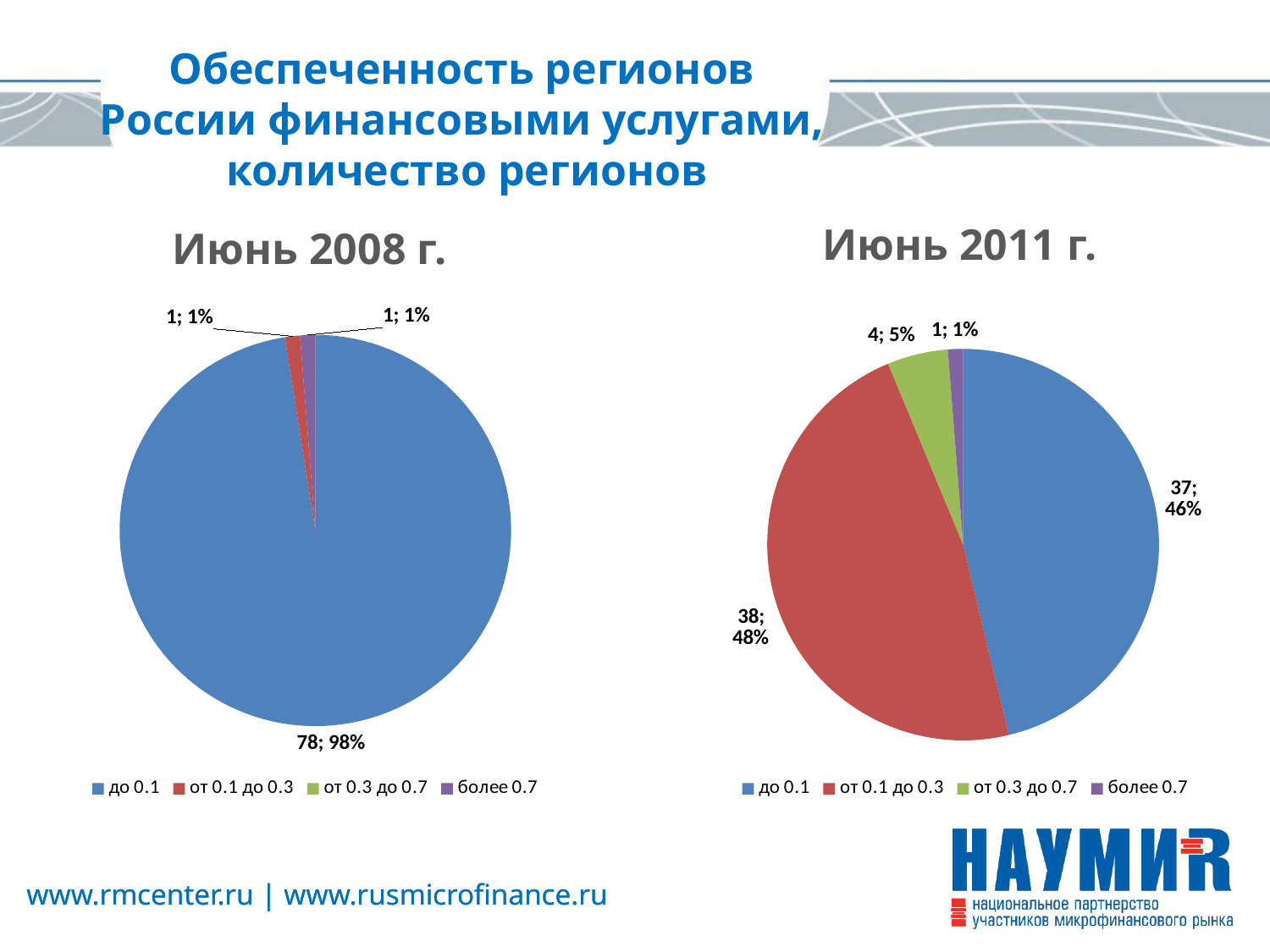
In the 'Июнь 2008 г.' chart, how many regions are in the 'до 0.1' category? 78 In the 'Июнь 2011 г.' chart, which category has the smallest slice? более 0.7 In the 'Июнь 2011 г.' chart, how many regions are in the 'от 0.1 до 0.3' category? 38 In the 'Июнь 2011 г.' chart, what colour is the 'от 0.3 до 0.7' slice? Green In the 'Июнь 2011 г.' chart, how many regions are in the 'от 0.3 до 0.7' category? 4 In the 'Июнь 2011 г.' chart, what is the difference in the number of regions between 'от 0.1 до 0.3' and 'до 0.1'? 1 In the 'Июнь 2011 г.' chart, which category has the largest slice? от 0.1 до 0.3 What type of chart is used for 'Июнь 2011 г.'? Pie chart How many categories does the legend of the 'Июнь 2008 г.' chart list? 4 Which chart has more regions in the 'до 0.1' category, 'Июнь 2008 г.' or 'Июнь 2011 г.'? Июнь 2008 г. In the 'Июнь 2008 г.' chart, what share of the pie does the 'до 0.1' slice take? 98% In the 'Июнь 2011 г.' chart, what share of the pie does the 'до 0.1' slice take? 46%